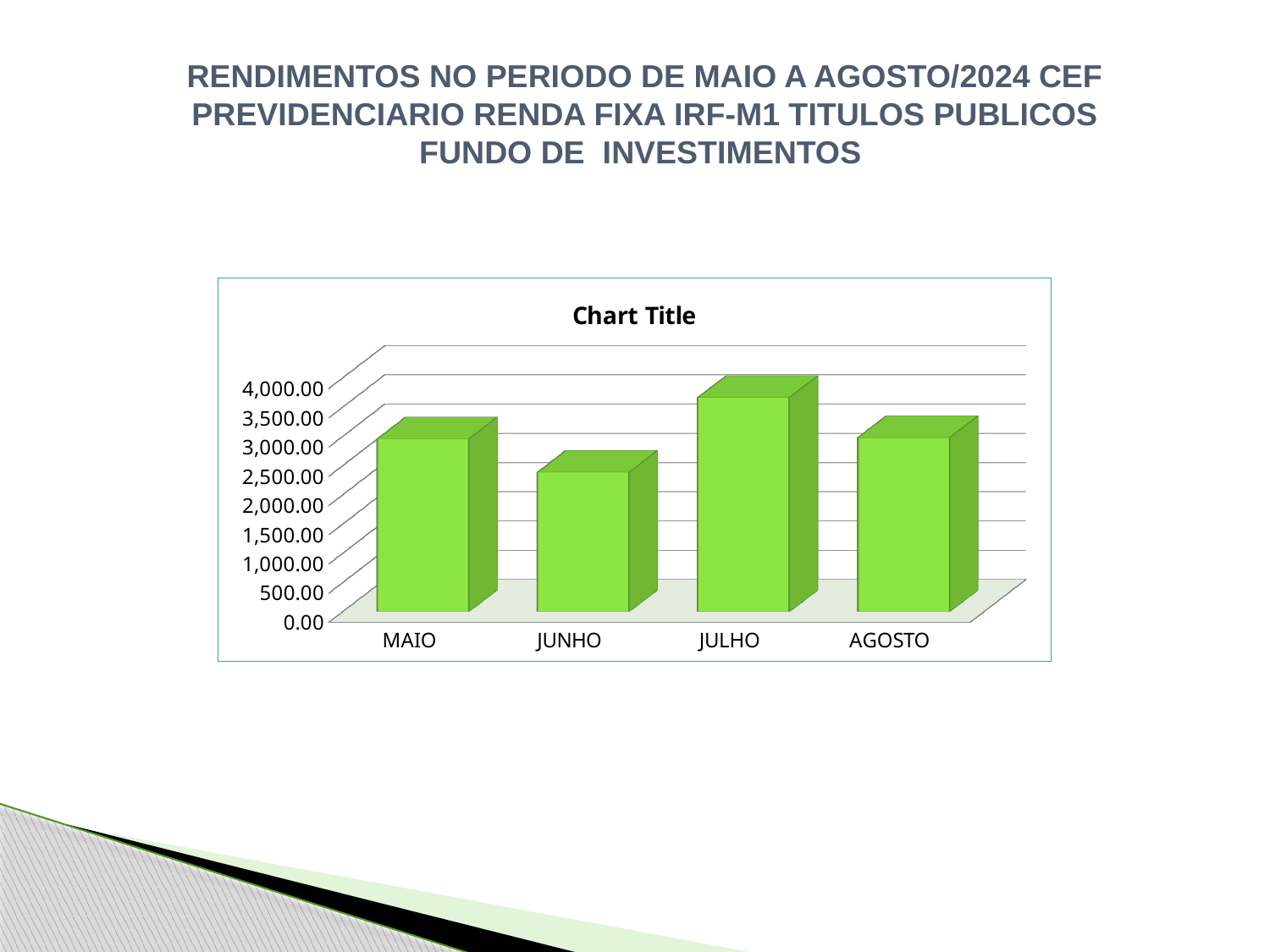
Which month has the highest value in the chart? JULHO Is the value for MAIO greater or less than 2,000.00? greater Does the value rise or fall from JUNHO to JULHO? rise What title is printed above the plot area of the chart? Chart Title How many months are shown on the x axis of the chart? 4 What kind of chart is shown on the slide? Bar chart Which is larger, the value for MAIO or the value for JUNHO? MAIO Is the value for AGOSTO greater or less than 2,000.00? greater Is the value for JUNHO greater or less than 3,000.00? less Which is larger, the value for JULHO or the value for JUNHO? JULHO Which month has the lowest value in the chart? JUNHO